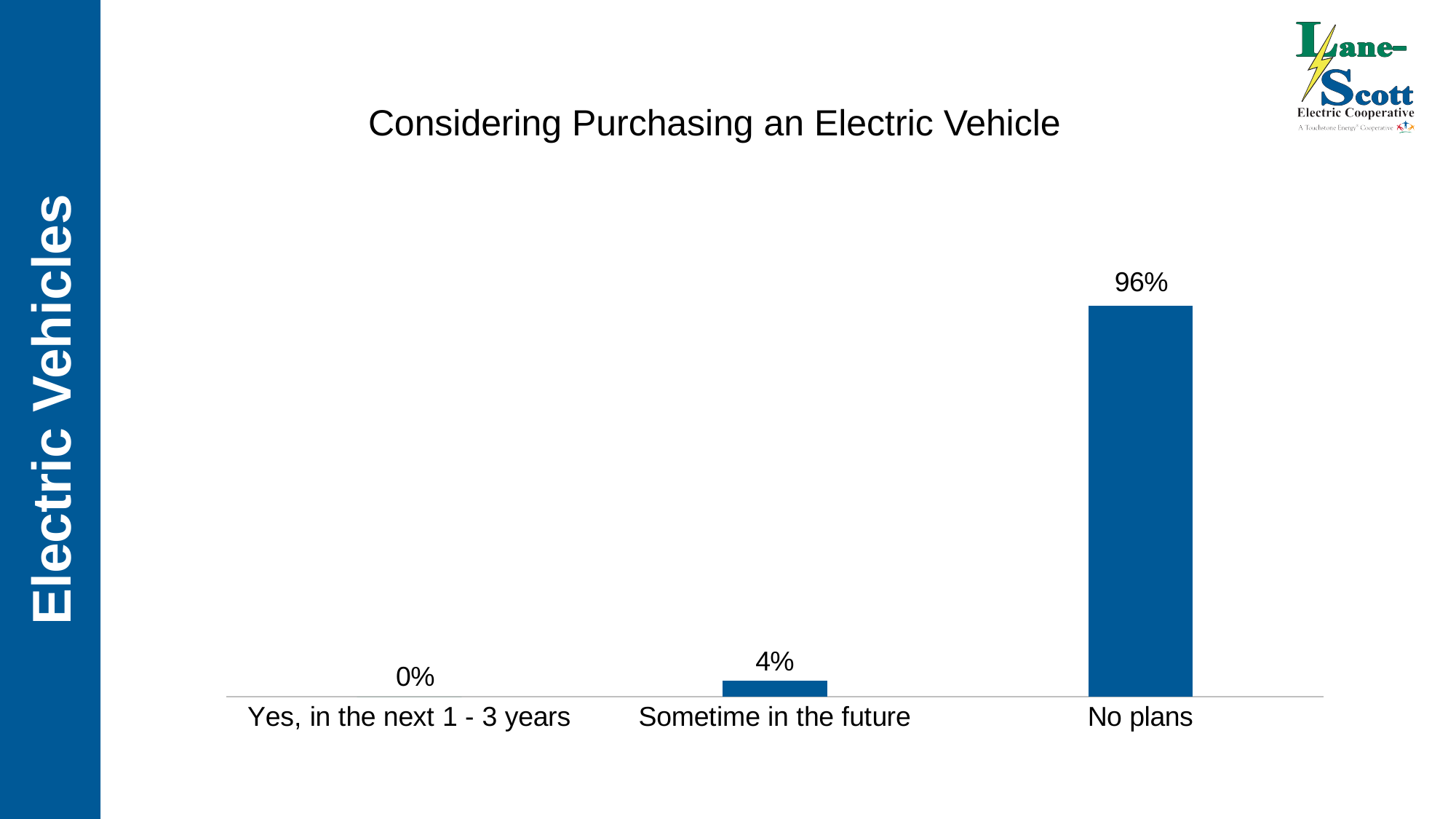
Which category has the highest value? No plans What is the value for "Yes, in the next 1 - 3 years"? 0% What is the value for "Sometime in the future"? 4% What is the title of the chart? Considering Purchasing an Electric Vehicle How many categories are shown on the x axis? 3 What kind of chart is shown on the slide? Bar chart What is the total of the three values shown on the chart? 100% Which category has the lowest value? Yes, in the next 1 - 3 years What is the difference between the values for "No plans" and "Sometime in the future"? 92% Which is larger, the value for "Sometime in the future" or the value for "Yes, in the next 1 - 3 years"? Sometime in the future Do the values rise or fall from left to right along the x axis? Rise What is the value for "No plans"? 96%